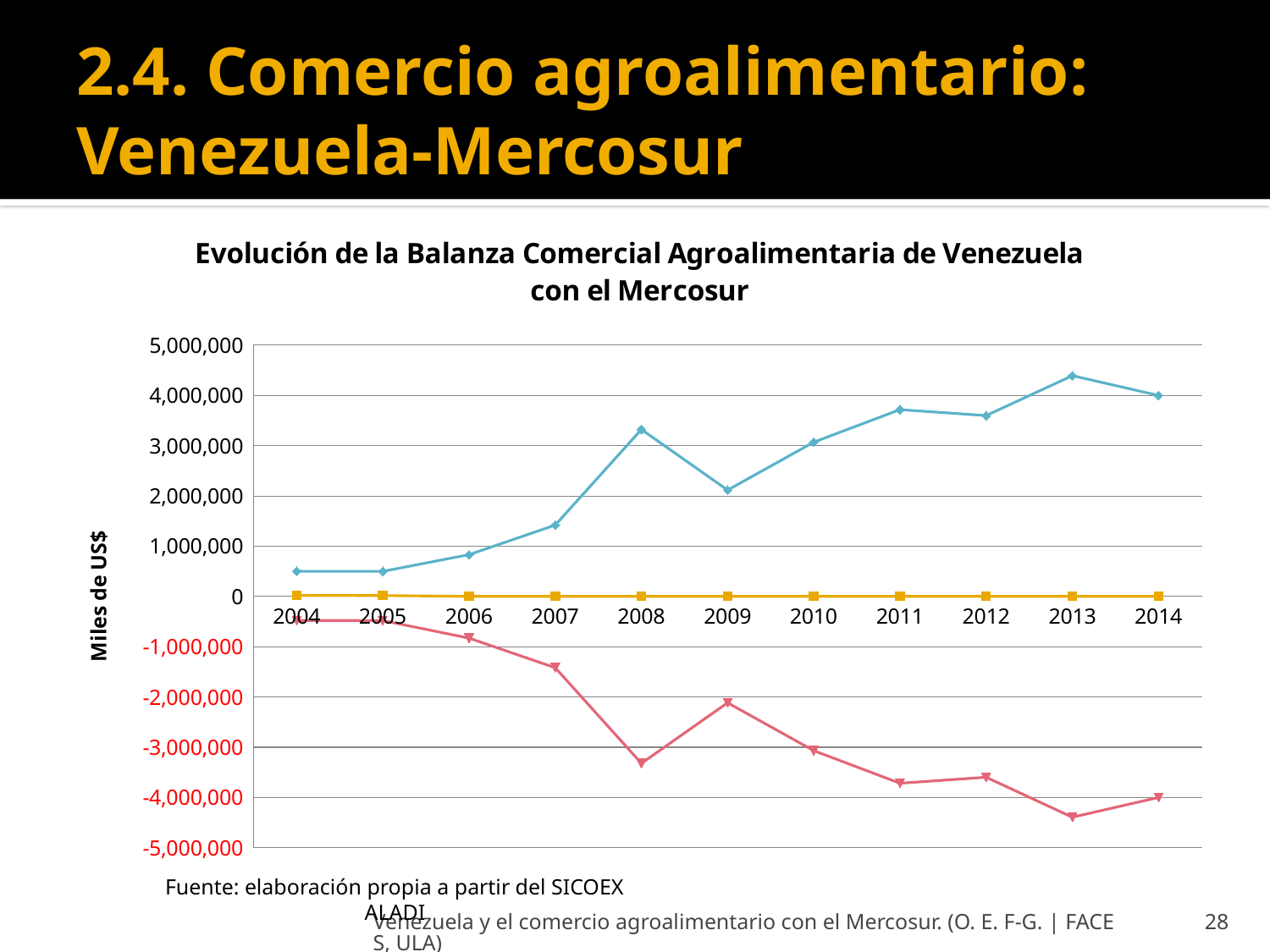
How many years are plotted along the x axis of the chart? 11 Which year has the higher value on the blue line, 2008 or 2009? 2008 Does the blue line generally rise or fall from 2004 to 2014? rise What kind of chart is shown on the slide? line chart In which year does the blue line reach its highest value? 2013 In which year does the red line reach its lowest value? 2013 Is the value of the blue line in 2006 greater or less than 1,000,000? less What is the label of the vertical axis of the chart? Miles de US$ Is the value of the red line in 2008 greater or less than -3,000,000? less Is the value of the blue line in 2008 greater or less than 3,000,000? greater What is the title of the chart? Evolución de la Balanza Comercial Agroalimentaria de Venezuela con el Mercosur